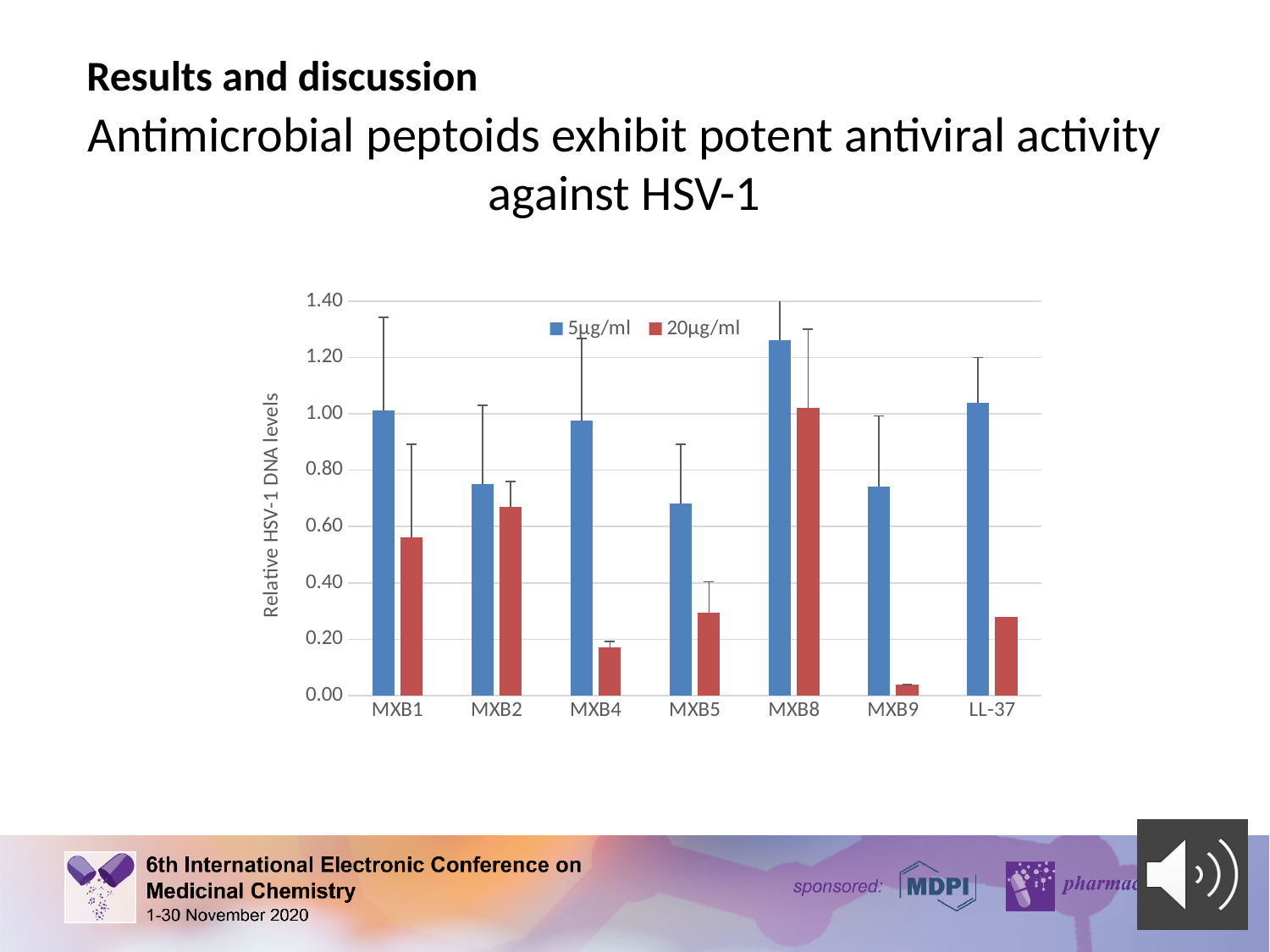
Is the 20µg/ml value for MXB8 greater or less than 0.80? greater How many categories are shown on the x axis of the chart? 7 Is the 5µg/ml value for MXB2 greater or less than 0.80? less What kind of chart is shown on the slide? bar chart Which category has the lowest value for the 20µg/ml series? MXB9 Which category has the highest value for the 20µg/ml series? MXB8 Is the 5µg/ml value for MXB8 greater or less than 1.20? greater For MXB4, which is larger: the 5µg/ml value or the 20µg/ml value? 5µg/ml Which category has the highest value for the 5µg/ml series? MXB8 What is the label of the y axis of the chart? Relative HSV-1 DNA levels How many series does the chart legend list? 2